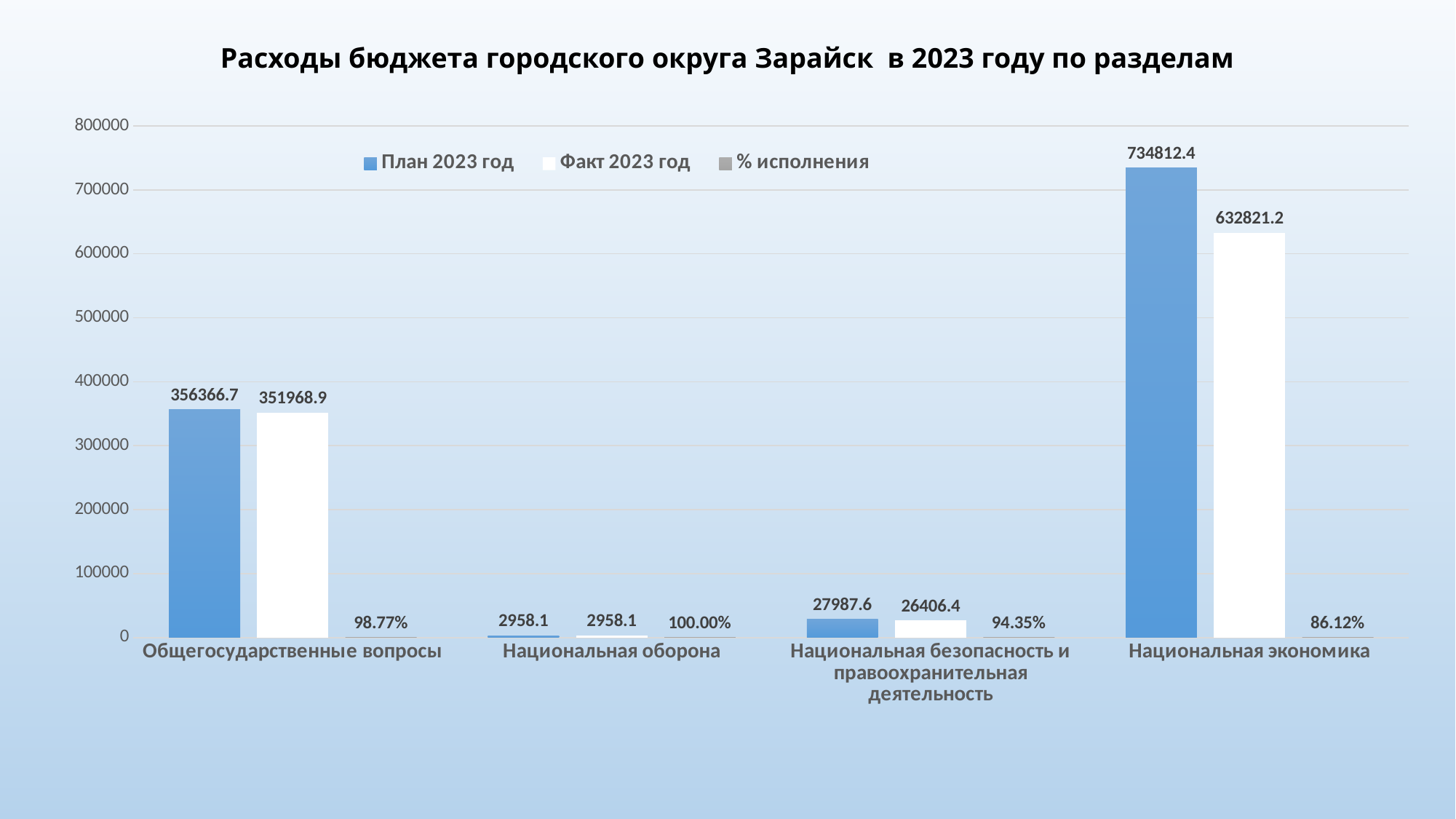
What kind of chart is shown on the slide? Bar chart What is the difference between the План 2023 год and Факт 2023 год values for Национальная экономика? 101991.2 What is the План 2023 год value for Национальная экономика? 734812.4 Which is larger: the Факт 2023 год value for Общегосударственные вопросы or for Национальная безопасность и правоохранительная деятельность? Общегосударственные вопросы What is the % исполнения value for Национальная безопасность и правоохранительная деятельность? 94.35% How many series does the legend list? 3 What is the Факт 2023 год value for Общегосударственные вопросы? 351968.9 Which category has the lowest Факт 2023 год value? Национальная оборона How many categories are shown on the x axis? 4 What is the Факт 2023 год value for Национальная оборона? 2958.1 What is the difference between the План 2023 год and Факт 2023 год values for Общегосударственные вопросы? 4397.8 Which category has the highest План 2023 год value? Национальная экономика